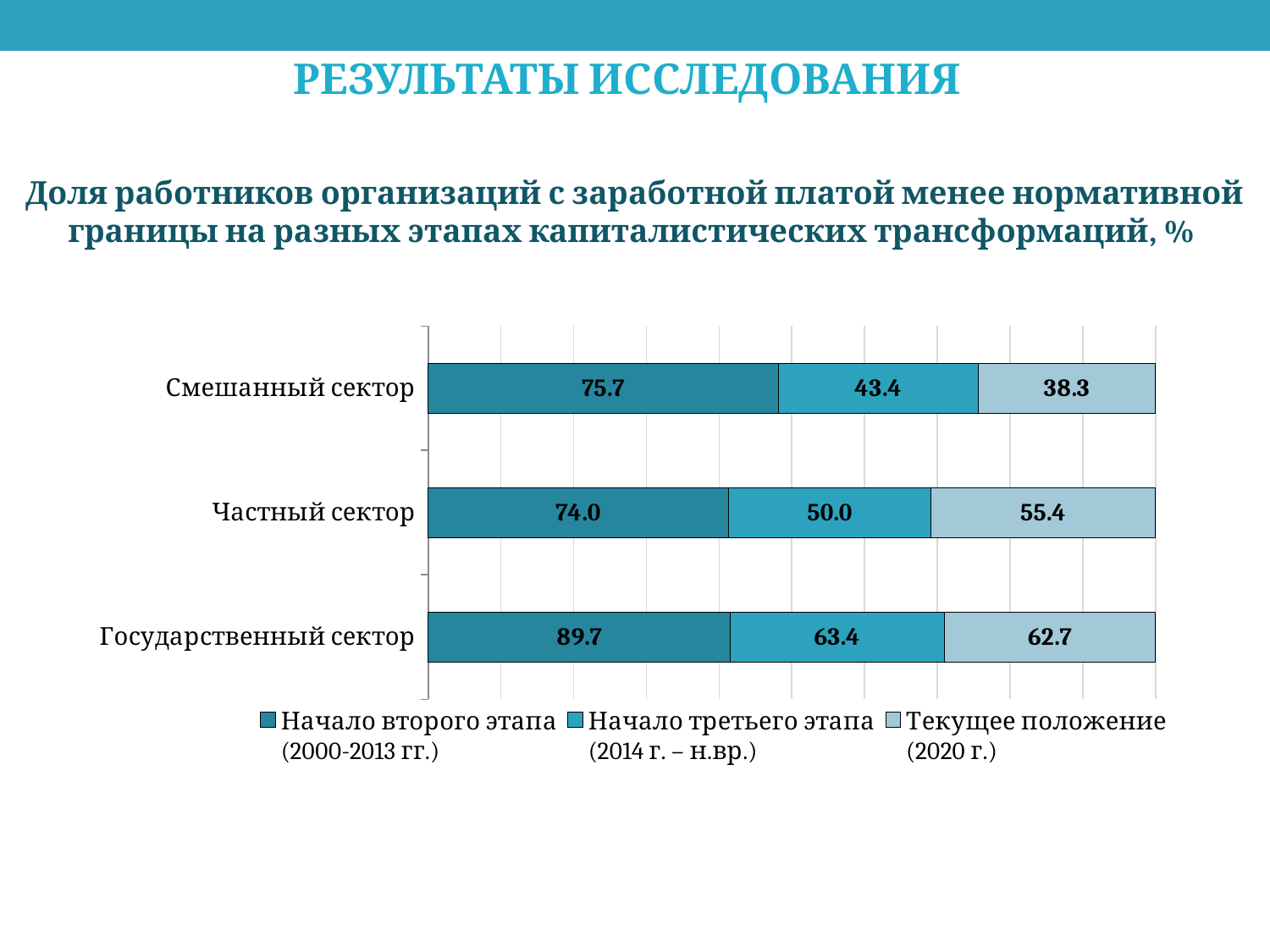
What is the value for Смешанный сектор in the series Начало третьего этапа (2014 г. – н.вр.)? 43.4 What is the difference between the Начало второго этапа and Текущее положение values for Смешанный сектор? 37.4 Which sector has the lowest value in the series Текущее положение (2020 г.)? Смешанный сектор What is the difference between the Начало второго этапа and Начало третьего этапа values for Государственный сектор? 26.3 How many sectors (categories) are shown in the chart? 3 What type of chart is shown on the slide? Stacked bar chart Which is larger for Частный сектор: the Начало третьего этапа value or the Текущее положение value? Текущее положение (55.4) What is the value for Государственный сектор in the series Начало второго этапа (2000-2013 гг.)? 89.7 Which sector has the highest value in the series Начало второго этапа (2000-2013 гг.)? Государственный сектор What is the sum of the three labelled values for Частный сектор? 179.4 How many series does the legend list? 3 What is the value for Частный сектор in the series Текущее положение (2020 г.)? 55.4